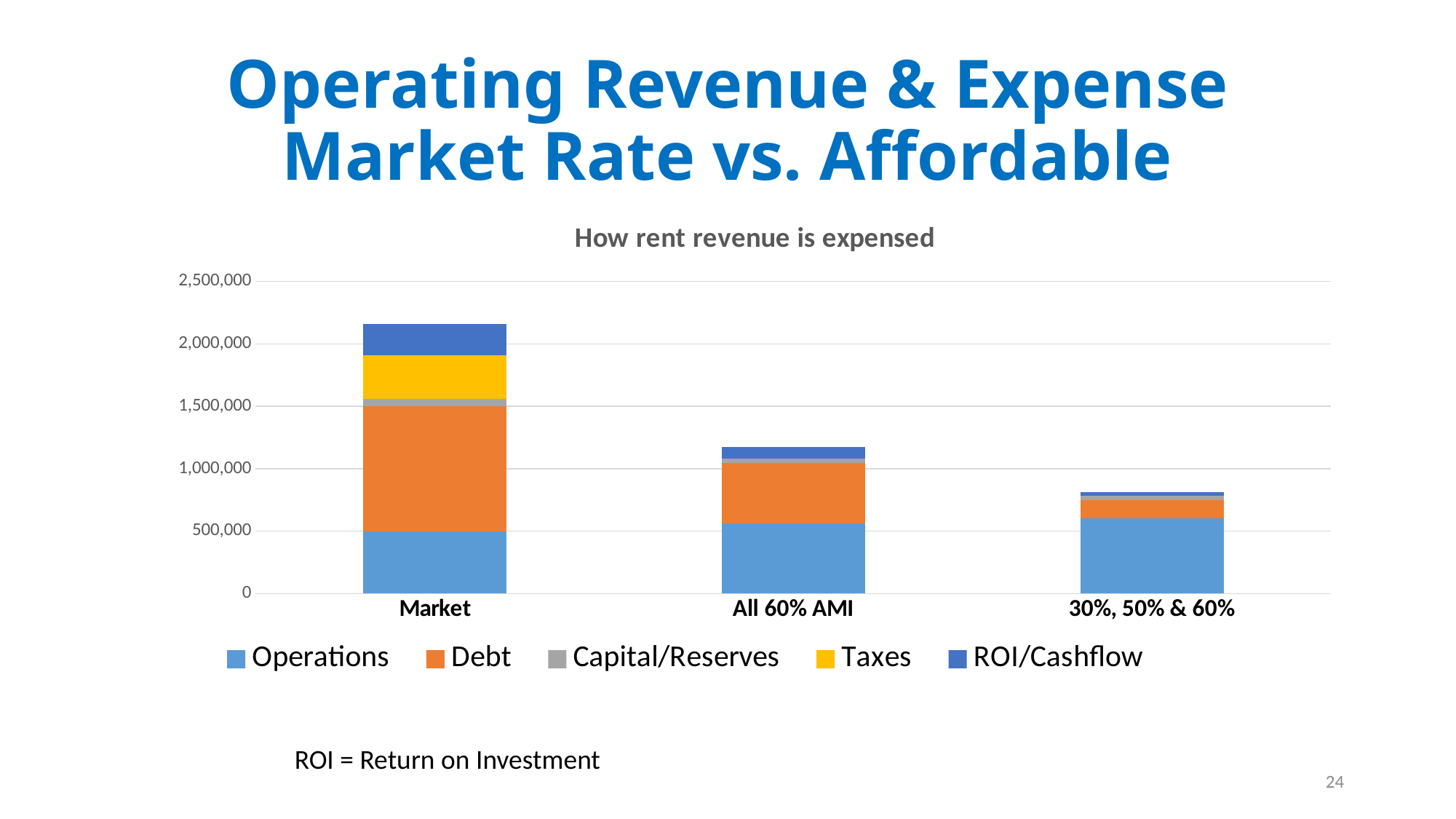
Which category has the tallest stacked bar? Market How many series does the legend list? 5 What is the title of the chart? How rent revenue is expensed Is the total of the Market bar greater or less than 2,000,000? greater Do the bar totals rise or fall from left to right across the x axis? fall Is the total of the 30%, 50% & 60% bar greater or less than 1,000,000? less Which category has the shortest stacked bar? 30%, 50% & 60% How many categories are shown on the x axis? 3 Which series is shown in yellow in the legend? Taxes What kind of chart is shown on the slide? stacked bar chart Is the total of the All 60% AMI bar greater or less than 1,000,000? greater